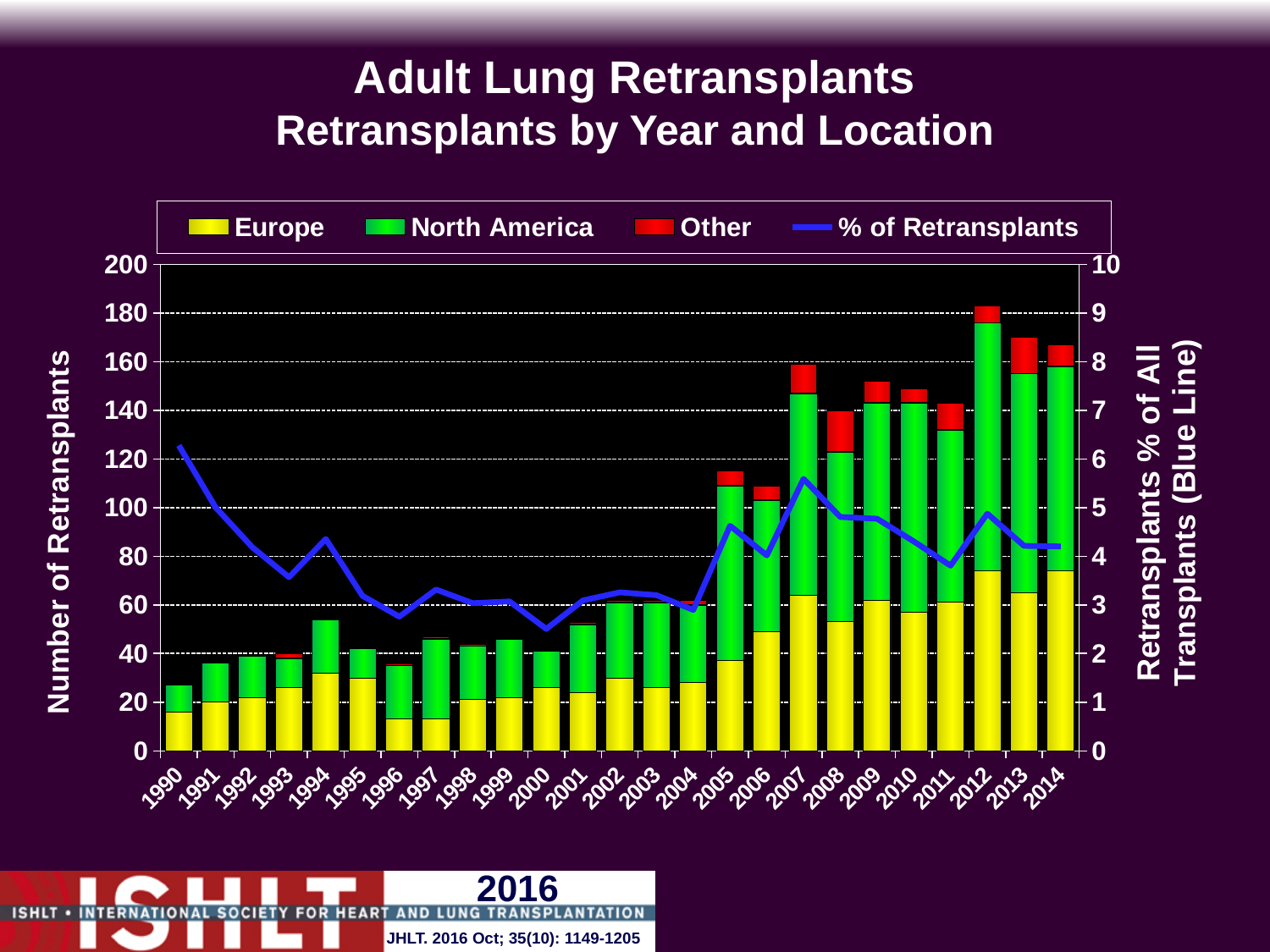
How many years are shown along the x axis? 25 Is the total number of retransplants in 2012 greater or less than 160? greater How many series does the legend list? 4 What kind of chart is shown on the slide? Stacked bar chart with a line Is the % of retransplants (blue line) in 2000 greater or less than 3? less What colour represents Europe in the legend? Yellow Which year has the shortest stacked bar for number of retransplants? 1990 Which year has the tallest stacked bar for number of retransplants? 2012 Is the total number of retransplants in 1990 greater or less than 40? less Does the blue % of Retransplants line rise or fall from 1990 to 1993? fall Which year has the taller stacked bar, 2006 or 2007? 2007